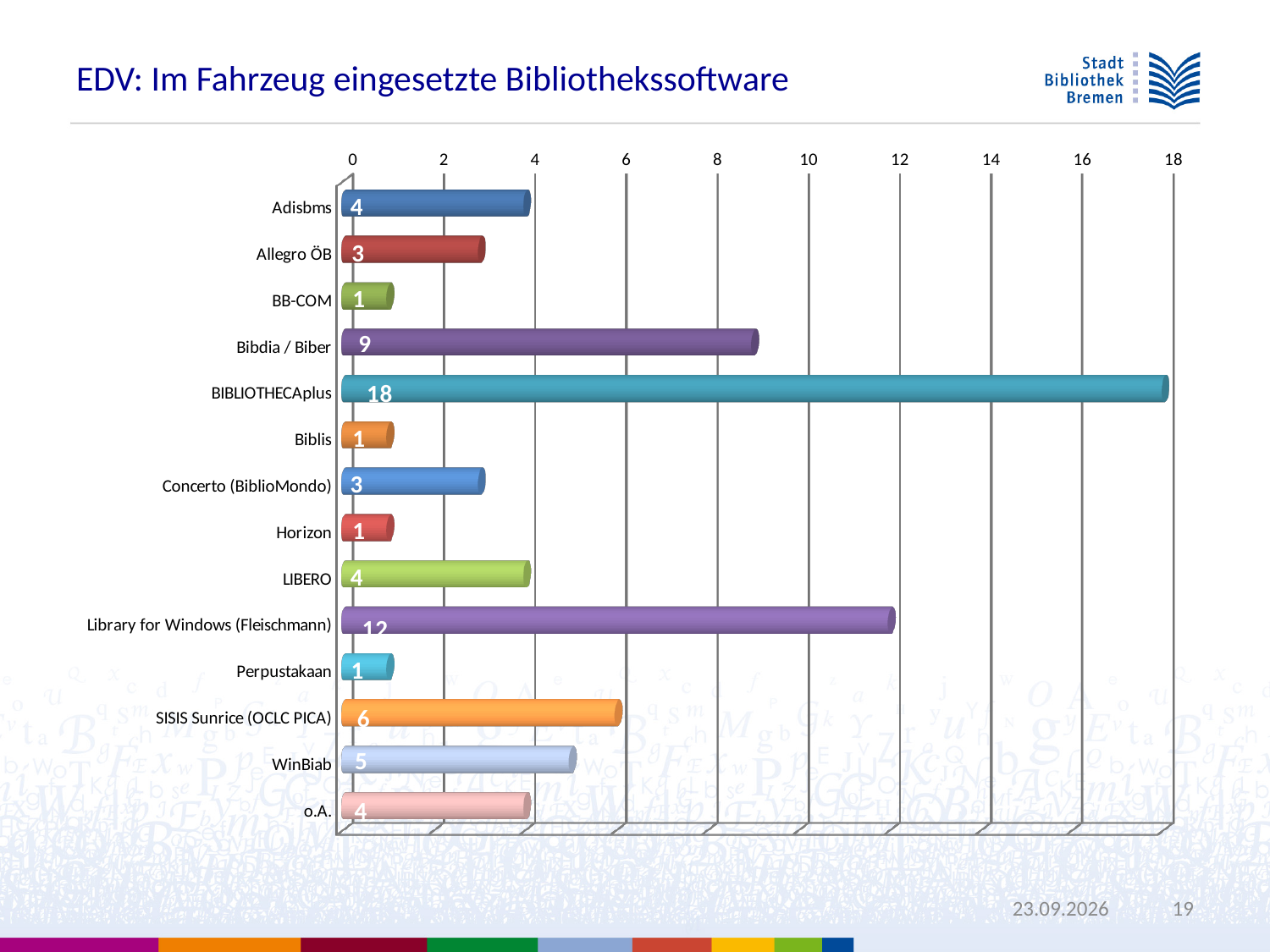
What is the difference between the values for SISIS Sunrice (OCLC PICA) and WinBiab? 1 What is the value for Bibdia / Biber? 9 What is the difference between the values for BIBLIOTHECAplus and Library for Windows (Fleischmann)? 6 What is the title of the slide containing the chart? EDV: Im Fahrzeug eingesetzte Bibliothekssoftware Is the value for Bibdia / Biber greater or less than 8? greater What is the value for SISIS Sunrice (OCLC PICA)? 6 How many categories are shown in the chart? 14 What is the value for BIBLIOTHECAplus? 18 What kind of chart is shown on the slide? bar chart Which is larger, the value for WinBiab or the value for Allegro ÖB? WinBiab Which category has the highest value? BIBLIOTHECAplus What is the value for Library for Windows (Fleischmann)? 12